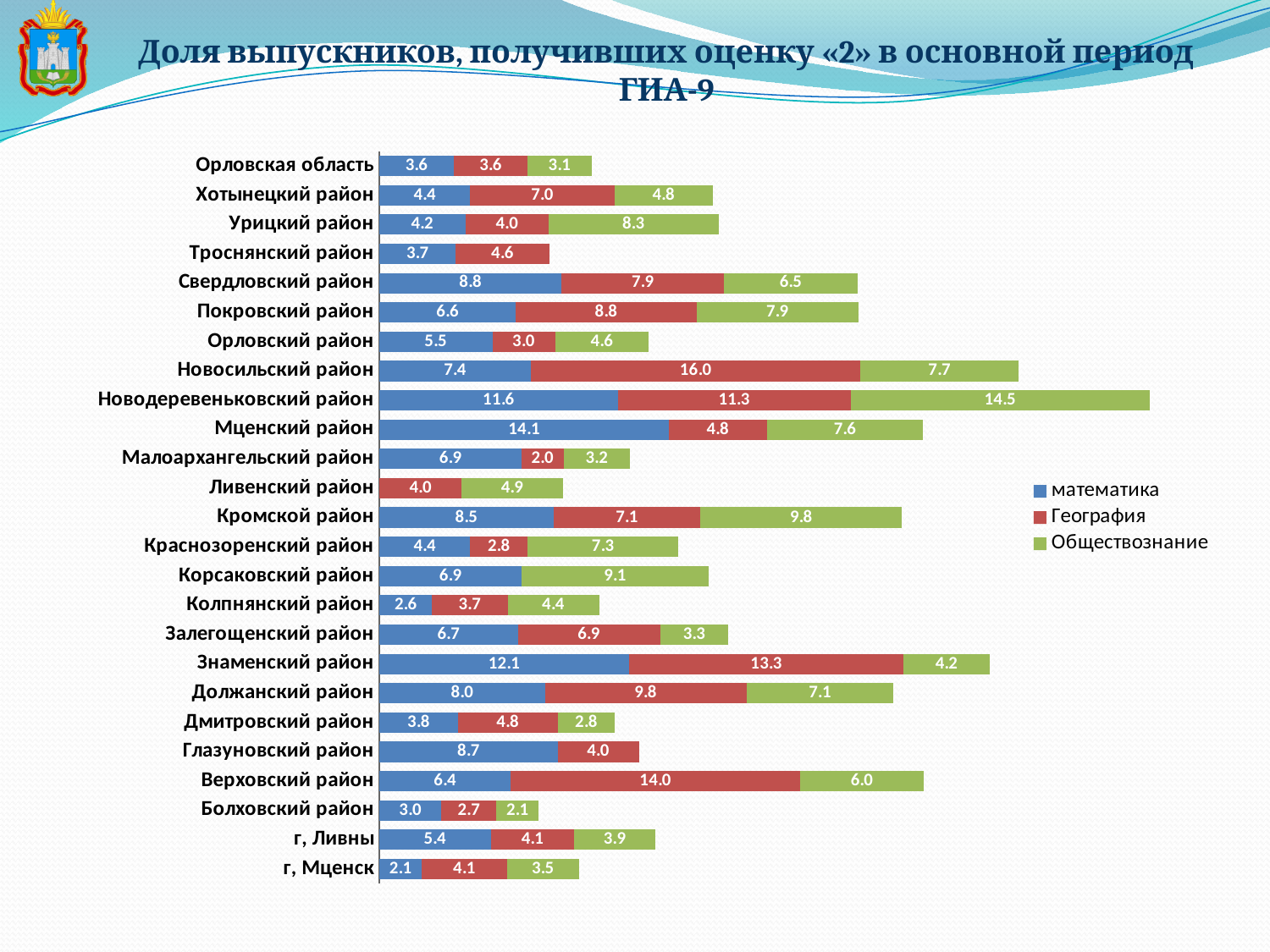
What is the difference between the География value for Верховский район and the География value for Орловская область? 10.4 Which is larger: the математика value for Знаменский район or the математика value for Должанский район? Знаменский район What is the value for География in Новосильский район? 16.0 How many categories are shown on the chart? 25 What is the value for математика in Мценский район? 14.1 What is the total of the stacked bar for Новодеревеньковский район? 37.4 What type of chart is shown on the slide? stacked bar chart Which category has the highest value for Обществознание? Новодеревеньковский район What is the value for Обществознание in Кромской район? 9.8 Which category has the highest value for География? Новосильский район Which category has the highest value for математика? Мценский район How many series does the legend list? 3